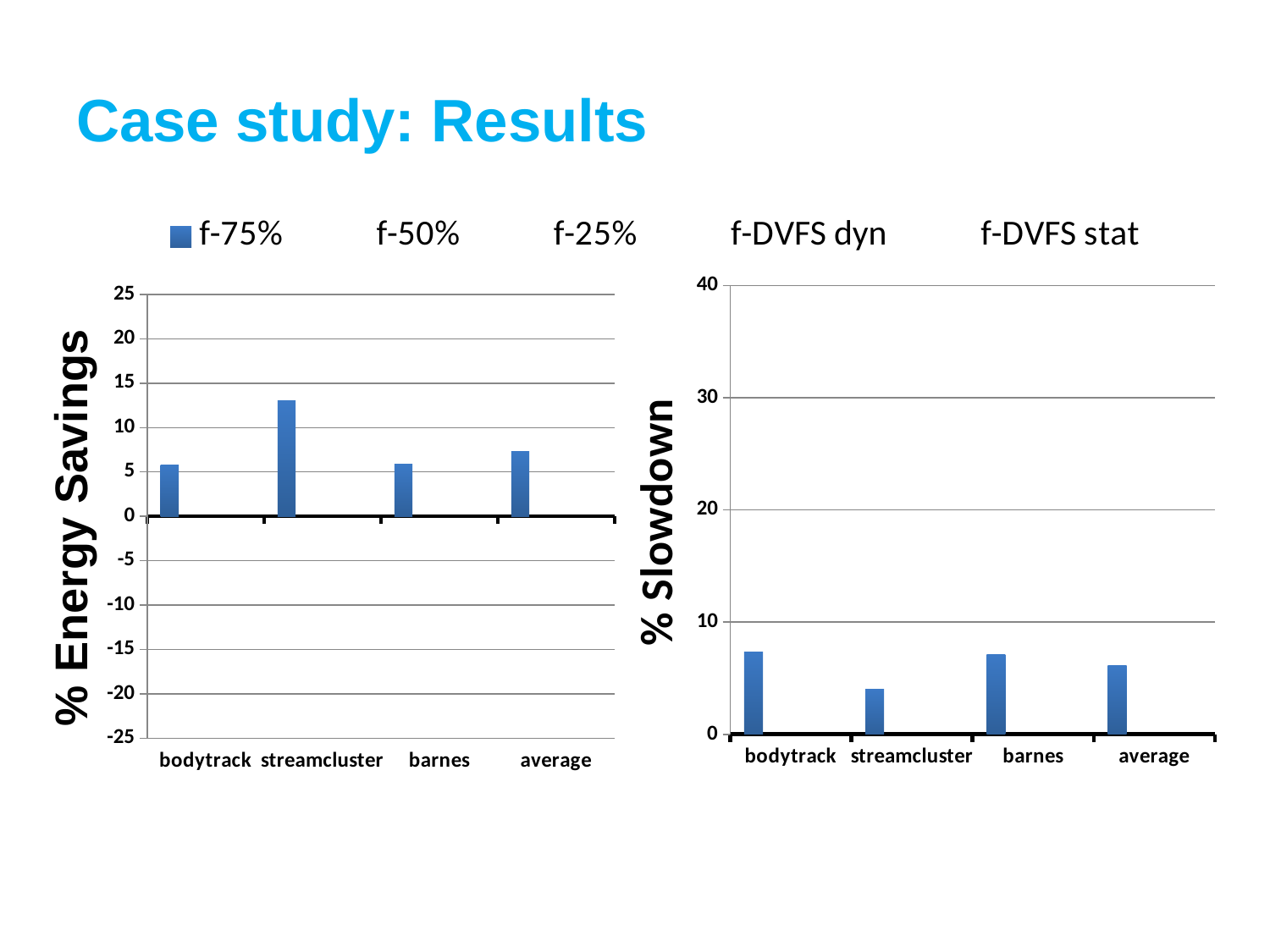
In the % Energy Savings chart on the left, is the value for streamcluster greater or less than 10? greater In the % Energy Savings chart on the left, which category has the highest value? streamcluster In the % Slowdown chart on the right, is the value for bodytrack greater or less than 10? less In the % Slowdown chart on the right, is the value for streamcluster greater or less than 5? less How many entries does the legend at the top of the slide list? 5 In the % Slowdown chart on the right, which category has the lowest value? streamcluster In the % Slowdown chart on the right, which is larger, the value for barnes or the value for streamcluster? barnes How many categories are shown on the x axis of the % Slowdown chart on the right? 4 In the % Energy Savings chart on the left, which is larger, the value for streamcluster or the value for barnes? streamcluster What kind of chart is the % Energy Savings chart on the left? bar chart